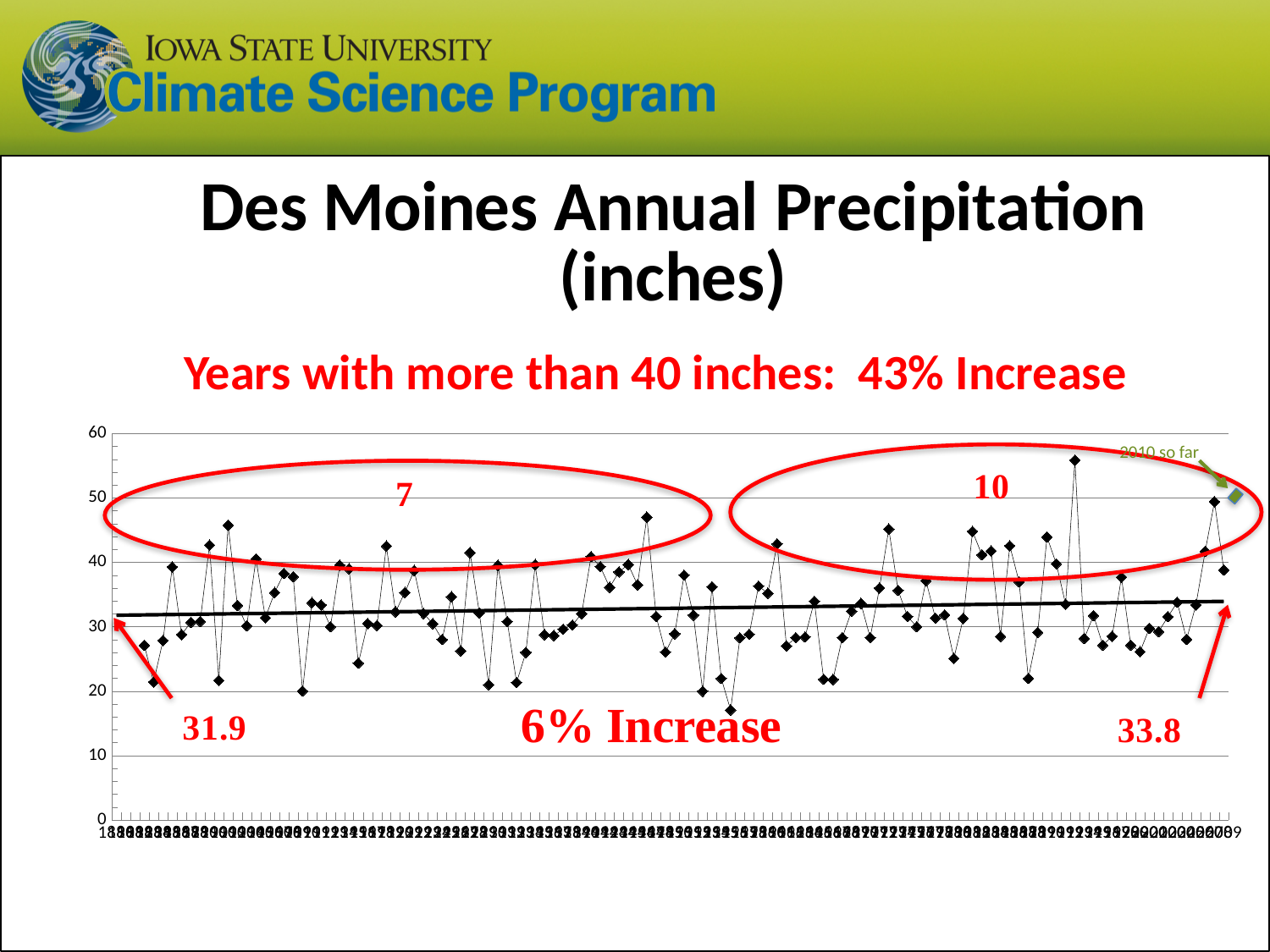
What is the title of the chart? Des Moines Annual Precipitation (inches) Is the highest plotted precipitation value greater or less than 50? greater According to the red subtitle, by what percentage did the number of years with more than 40 inches increase? 43% How many years with more than 40 inches are counted in the right red circle? 10 What is the maximum value shown on the y axis? 60 What value is labelled at the start of the trend line on the left of the chart? 31.9 Does the trend line rise or fall from left to right across the chart? rise Is the lowest plotted precipitation value greater or less than 20? less How many years with more than 40 inches are counted in the left red circle? 7 What kind of chart is shown on the slide? line chart What value is labelled at the end of the trend line on the right of the chart? 33.8 What percentage increase is annotated along the trend line in the middle of the chart? 6% Increase